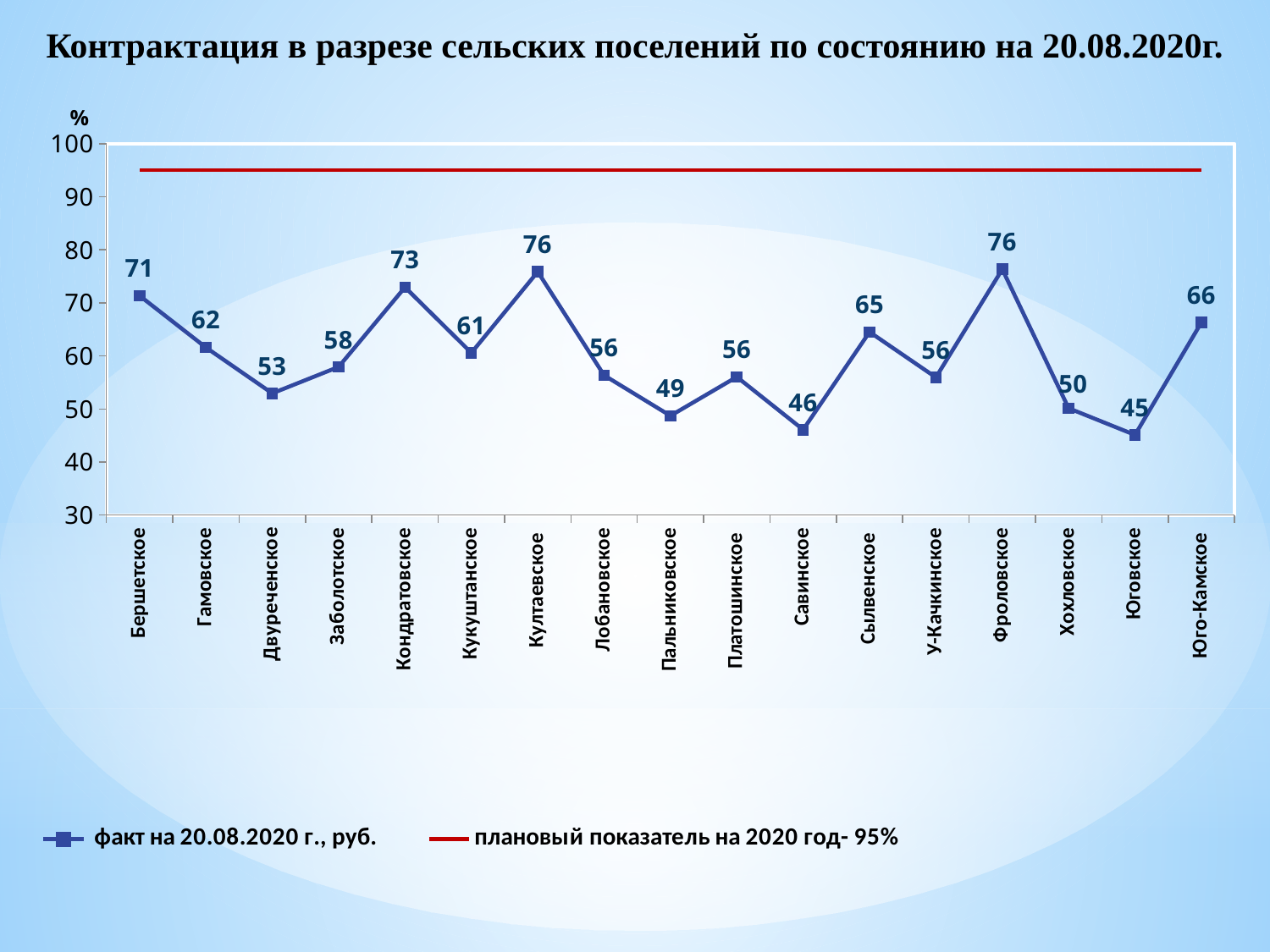
Is the value for Пальниковское greater or less than 50? less What is the value for Бершетское? 71 How many settlements are shown on the x axis? 17 What is the value for Юго-Камское? 66 What is the difference between the values for Фроловское and Юговское? 31 What is the value for Савинское? 46 What is the difference between the values for Кондратовское and Двуреченское? 20 What planned target value does the red line represent? 95% Which is larger, the value for Сылвенское or the value for Хохловское? Сылвенское How many series does the legend list? 2 Which settlement has the lowest value? Юговское What kind of chart is shown on the slide? line chart